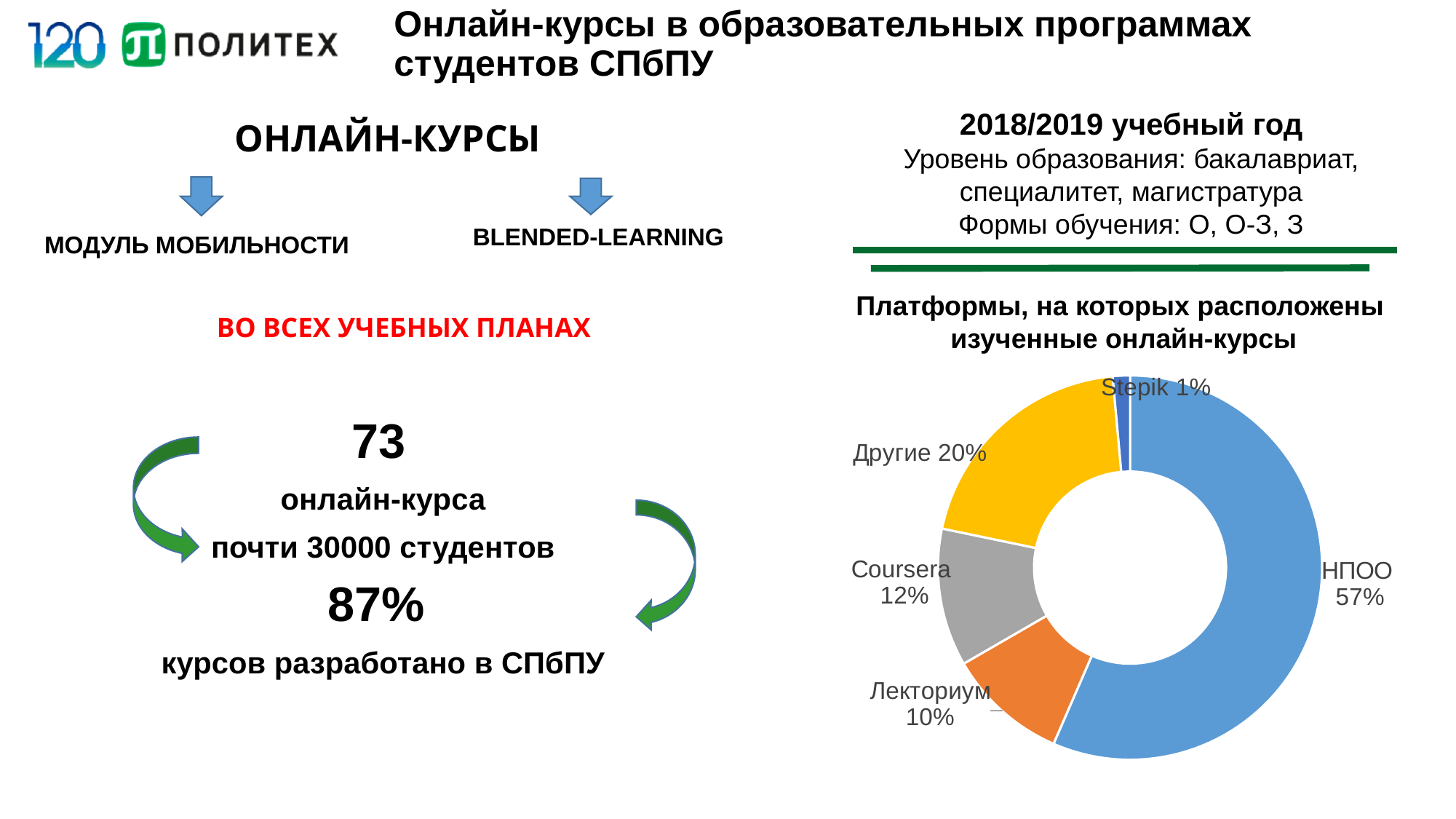
How many categories are shown in the chart? 5 What is the title of the chart? Платформы, на которых расположены изученные онлайн-курсы What is the difference in percentage points between НПОО and Другие? 37 What type of chart is shown on the slide? Doughnut chart Which has a larger share, Другие or Coursera? Другие What percentage is shown for Лекториум in the chart? 10% What share of the doughnut chart does НПОО account for? 57% What percentage is shown for Stepik in the chart? 1% Which platform has the largest share in the chart? НПОО What percentage is shown for Coursera in the chart? 12% Which platform has the smallest share in the chart? Stepik What is the difference in percentage points between Coursera and Лекториум? 2